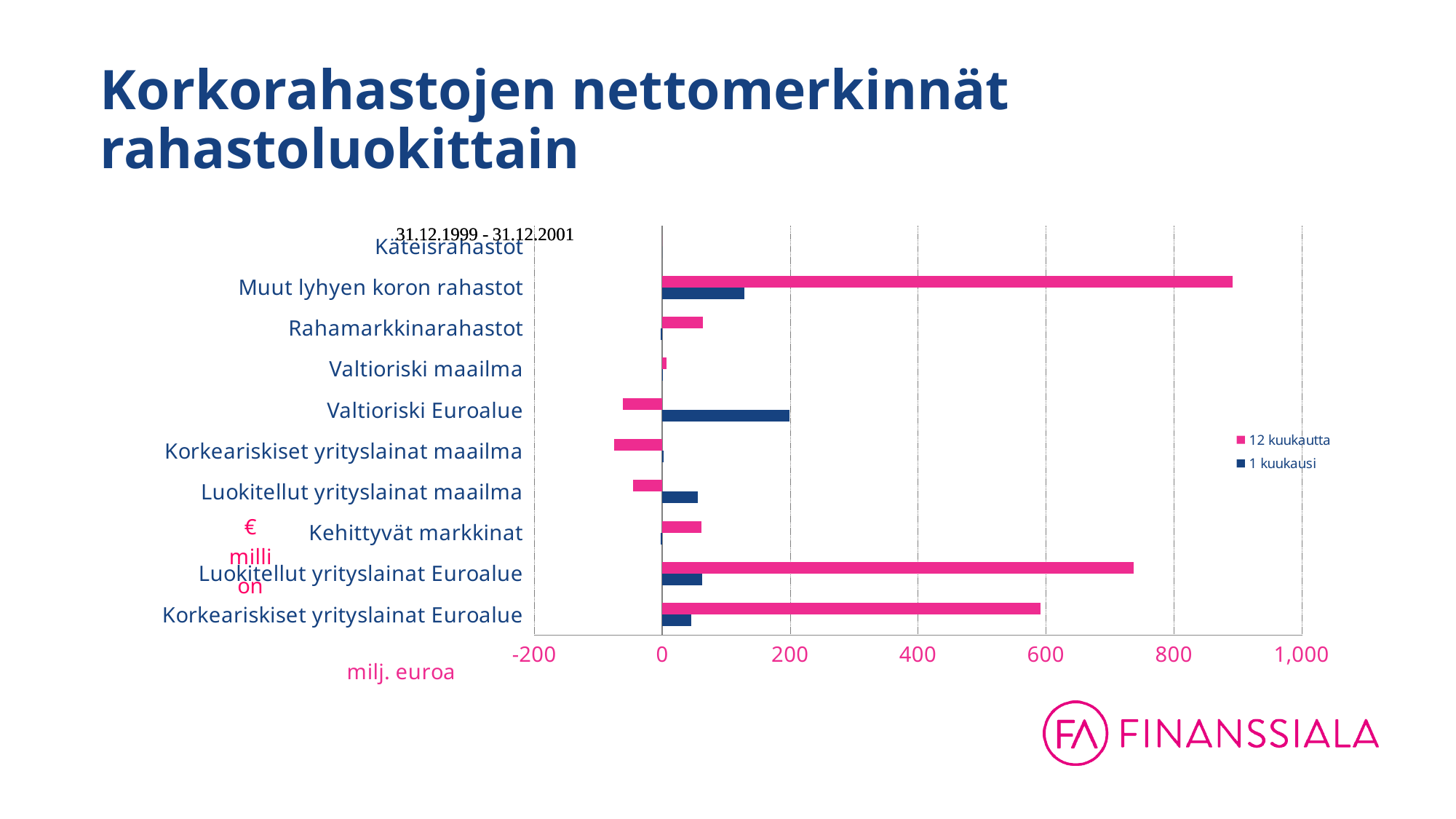
What kind of chart is shown on the slide? bar chart What unit is shown below the horizontal axis of the chart? milj. euroa Which category has the highest value for the 1 kuukausi series? Valtioriski Euroalue Is the 12 kuukautta value for Korkeariskiset yrityslainat Euroalue greater or less than 400? greater Is the 12 kuukautta value for Muut lyhyen koron rahastot greater or less than 800? greater Is the 12 kuukautta value for Valtioriski Euroalue greater or less than 0? less How many series does the legend list? 2 For the 1 kuukausi series, which is larger: Valtioriski Euroalue or Korkeariskiset yrityslainat Euroalue? Valtioriski Euroalue Which category has the highest value for the 12 kuukautta series? Muut lyhyen koron rahastot How many fund categories are listed on the vertical axis of the chart? 10 For the 12 kuukautta series, which is larger: Muut lyhyen koron rahastot or Luokitellut yrityslainat Euroalue? Muut lyhyen koron rahastot